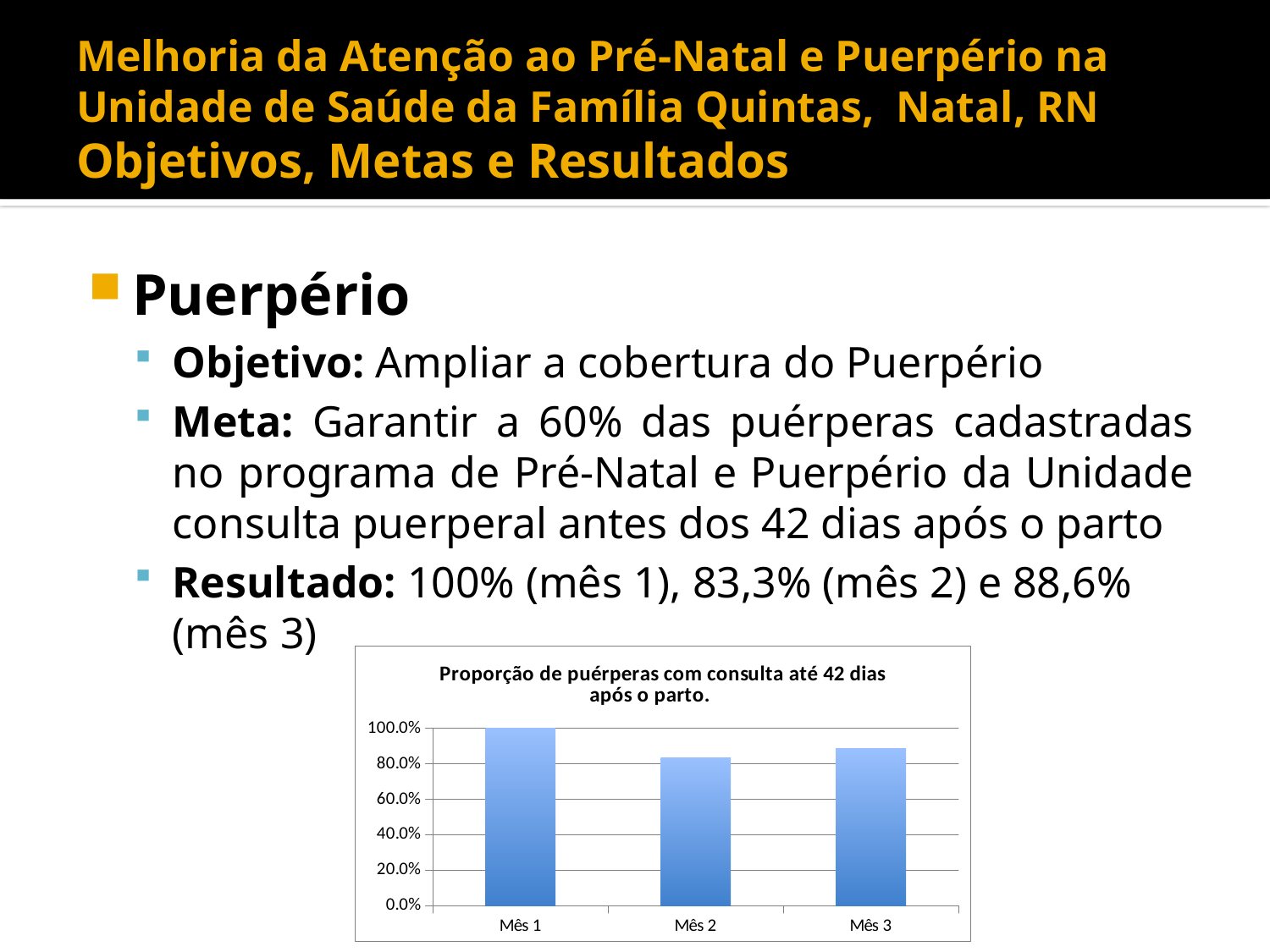
Is the value for Mês 2 greater or less than 80.0%? greater How many categories (months) are plotted in the chart? 3 According to the slide, what is the result for mês 2? 83,3% Which month has the highest bar in the chart? Mês 1 What is the title of the chart? Proporção de puérperas com consulta até 42 dias após o parto. Which month has the lowest bar in the chart? Mês 2 Is the value for Mês 3 greater or less than 100.0%? less What is the difference between the values for Mês 1 and Mês 2, as given on the slide? 16,7% Which is larger, the value for Mês 2 or the value for Mês 3? Mês 3 According to the slide, what is the result for mês 3? 88,6% What kind of chart is shown on the slide? bar chart What is the value for Mês 1 in the chart? 100.0%